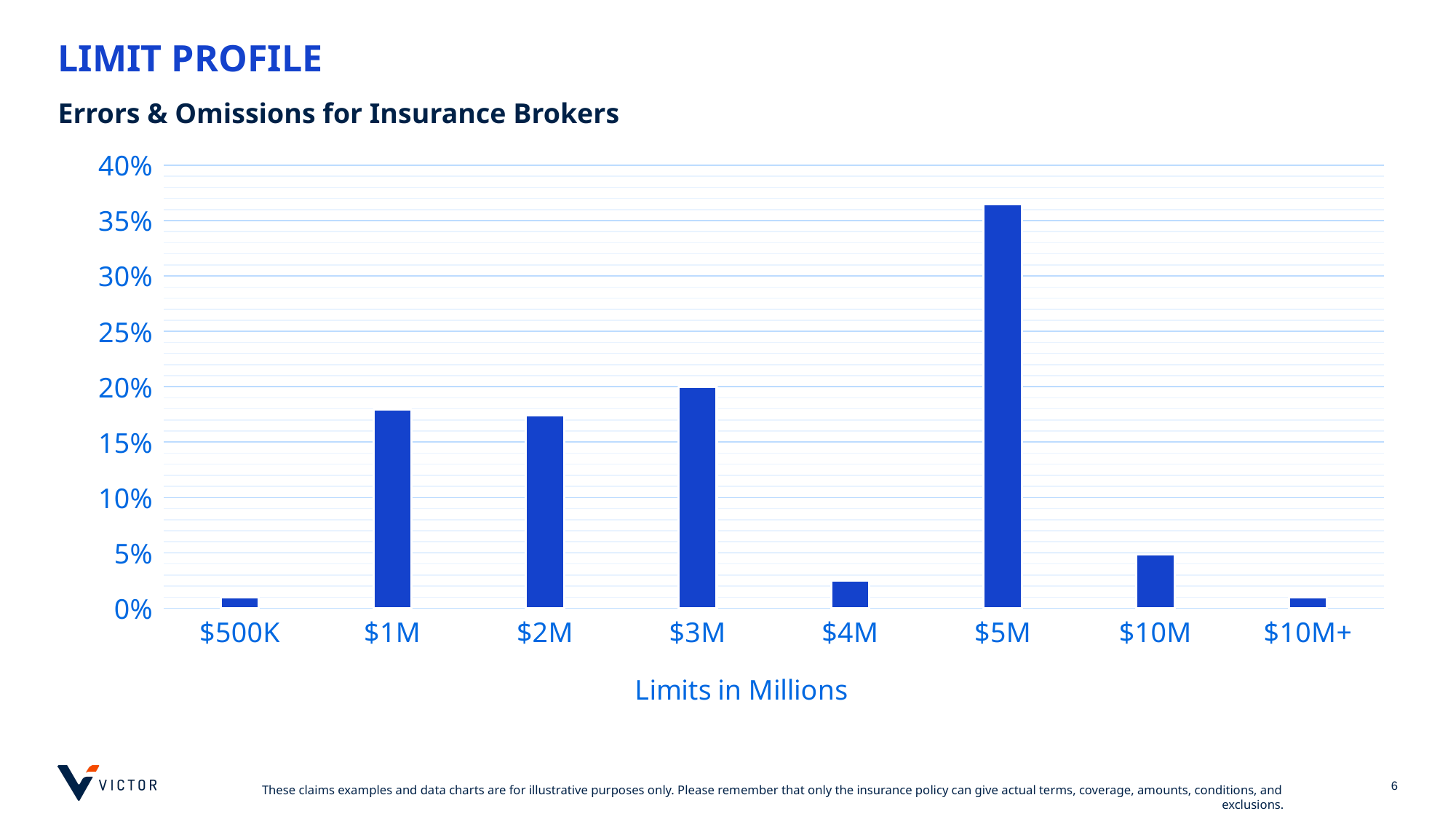
Which limit category has the highest percentage? $5M Is the value for $10M greater or less than 10%? less How many limit categories are shown on the x axis? 8 Which is larger, the value for $10M or the value for $4M? $10M What is the title of the x axis? Limits in Millions What kind of chart is shown on the slide? bar chart Is the value for $5M greater or less than 35%? greater Which is larger, the value for $3M or the value for $5M? $5M Is the value for $1M greater or less than 15%? greater